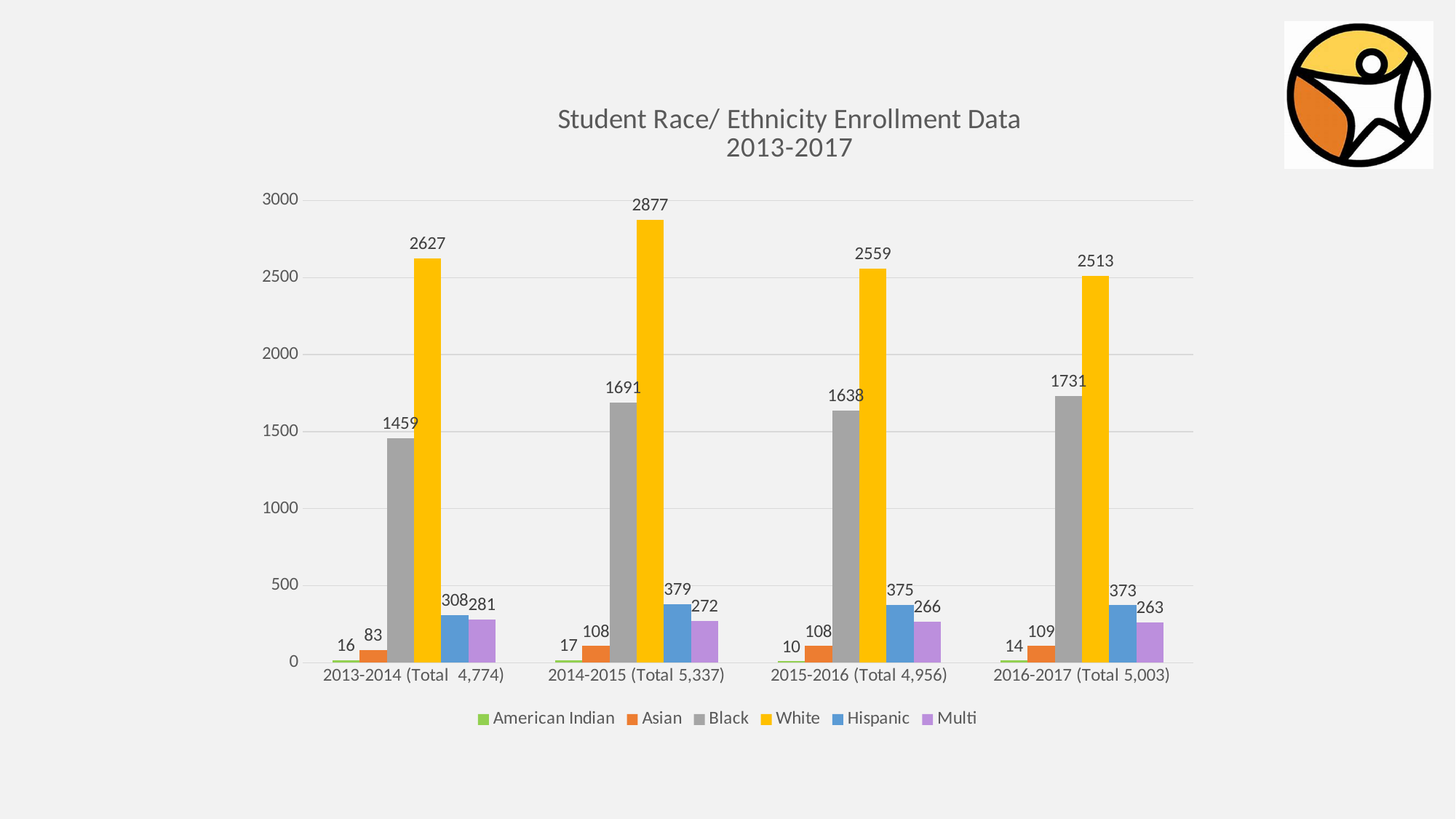
What is the difference between the White and Black enrollment in 2015-2016? 921 Which year has the highest White enrollment? 2014-2015 What is the Hispanic enrollment value for 2013-2014? 308 How many school years are shown on the x axis? 4 How many series does the legend list? 6 What kind of chart is shown on the slide? bar chart Which is larger in 2016-2017, the Hispanic value or the Multi value? Hispanic Is the Black enrollment value for 2013-2014 greater or less than 1500? less What is the White enrollment value for 2014-2015? 2877 Which year has the lowest American Indian enrollment? 2015-2016 What is the Black enrollment value for 2016-2017? 1731 Does the Multi enrollment rise or fall from 2013-2014 to 2016-2017? fall